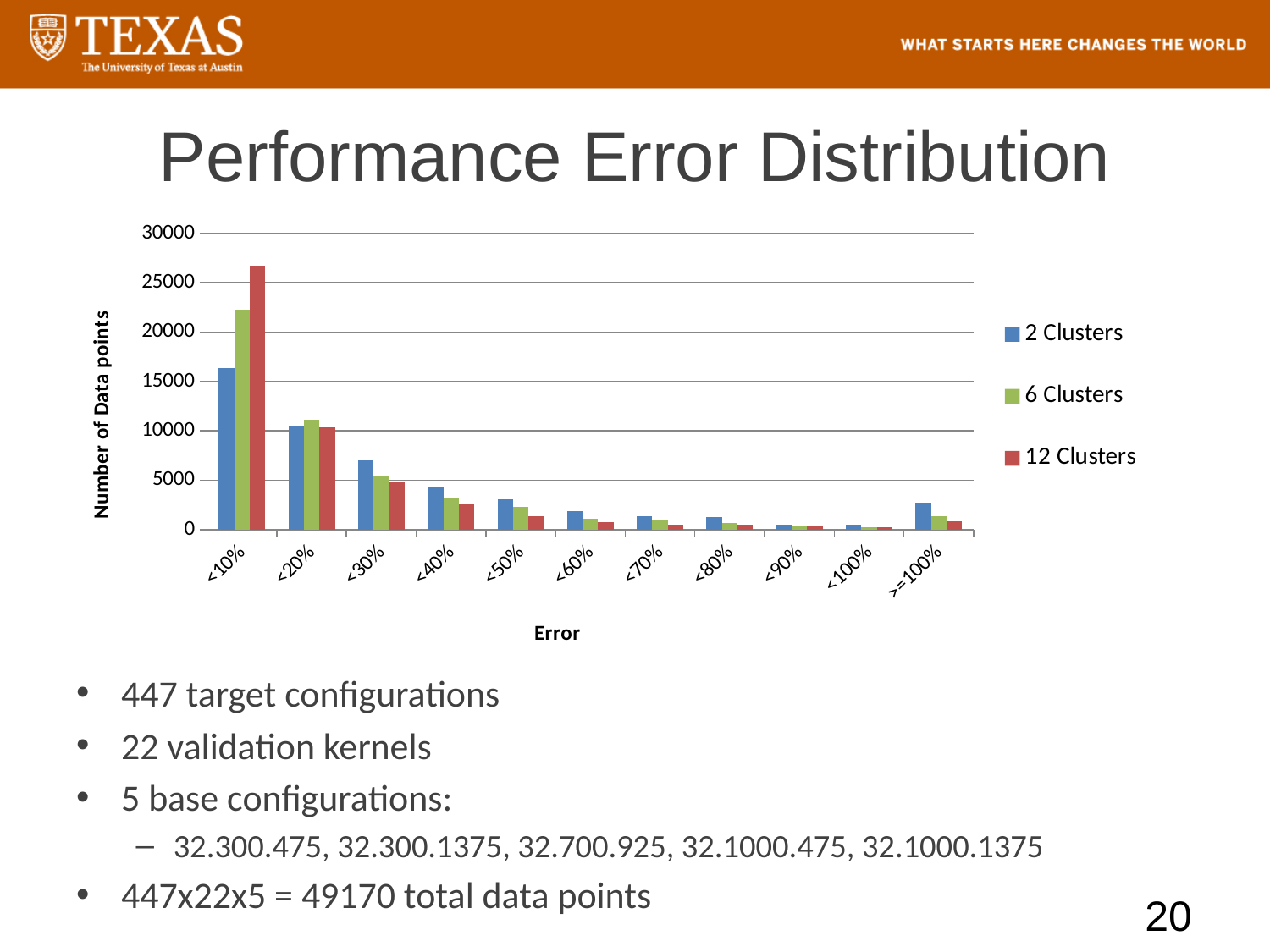
In the <10% category, which is larger: 2 Clusters or 12 Clusters? 12 Clusters Is the 2 Clusters value for <30% greater or less than 5000? greater For which error category is the 12 Clusters value highest? <10% What is the title of the y axis? Number of Data points Is the 12 Clusters value for <10% greater or less than 25000? greater In the <30% category, which is larger: 2 Clusters or 12 Clusters? 2 Clusters How many series does the legend list? 3 What kind of chart is shown on the slide? bar chart Do the 12 Clusters values rise or fall from <10% to <100% along the x axis? fall Is the 6 Clusters value for <10% greater or less than 20000? greater How many error categories are shown on the x axis? 11